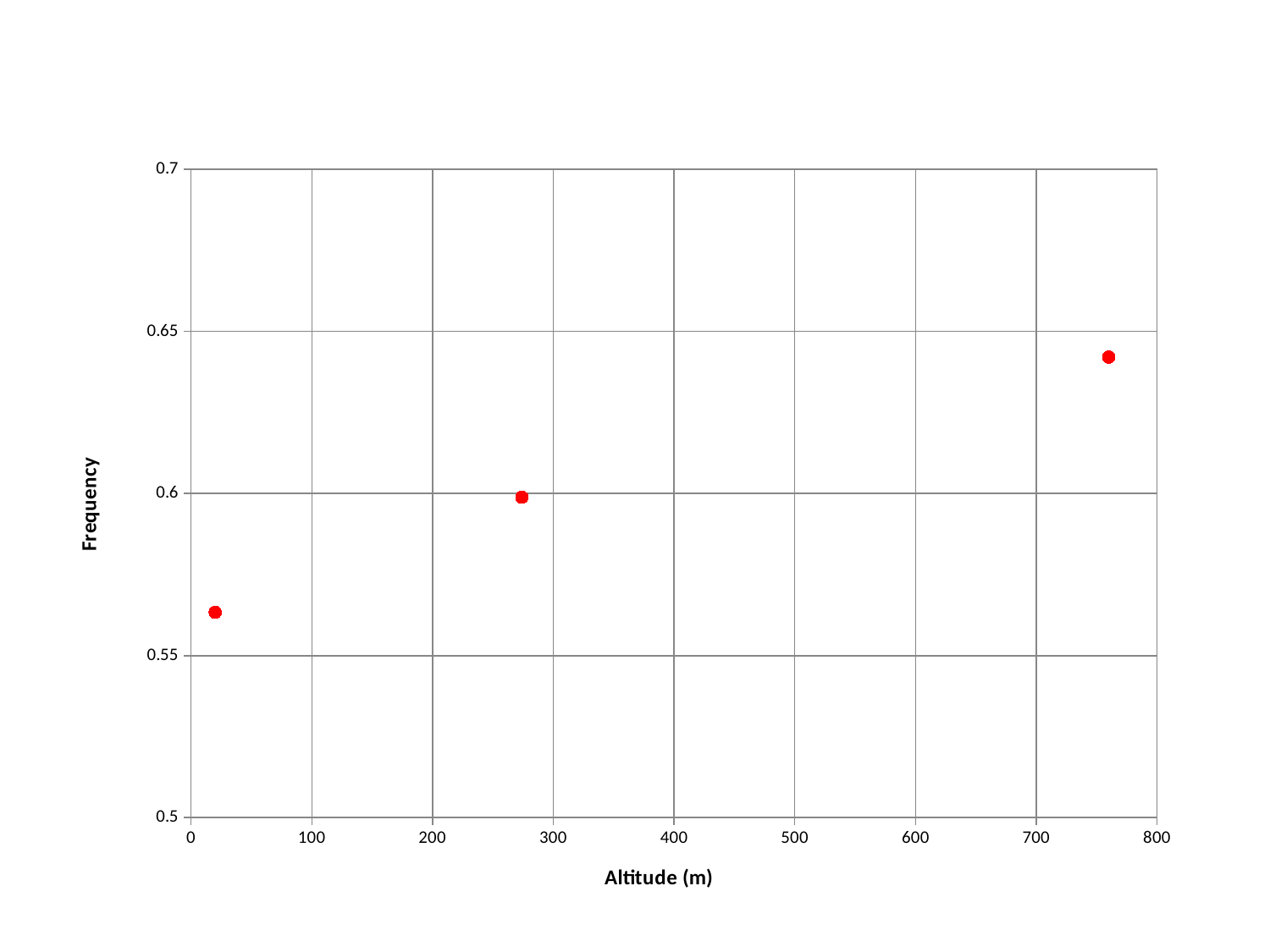
What is the title of the y axis? Frequency How many data points are plotted on the chart? 3 Does frequency rise or fall as altitude increases along the x axis? Rise What is the maximum value shown on the y axis? 0.7 Is the frequency of the point plotted at the highest altitude greater or less than 0.6? greater Is the altitude of the rightmost point greater or less than 700 m? greater What kind of chart is shown on the slide? Scatter chart Is the frequency of the point plotted at the lowest altitude greater or less than 0.55? greater Which has the higher frequency: the point at the lowest altitude or the point at the highest altitude? The point at the highest altitude What is the title of the x axis? Altitude (m)